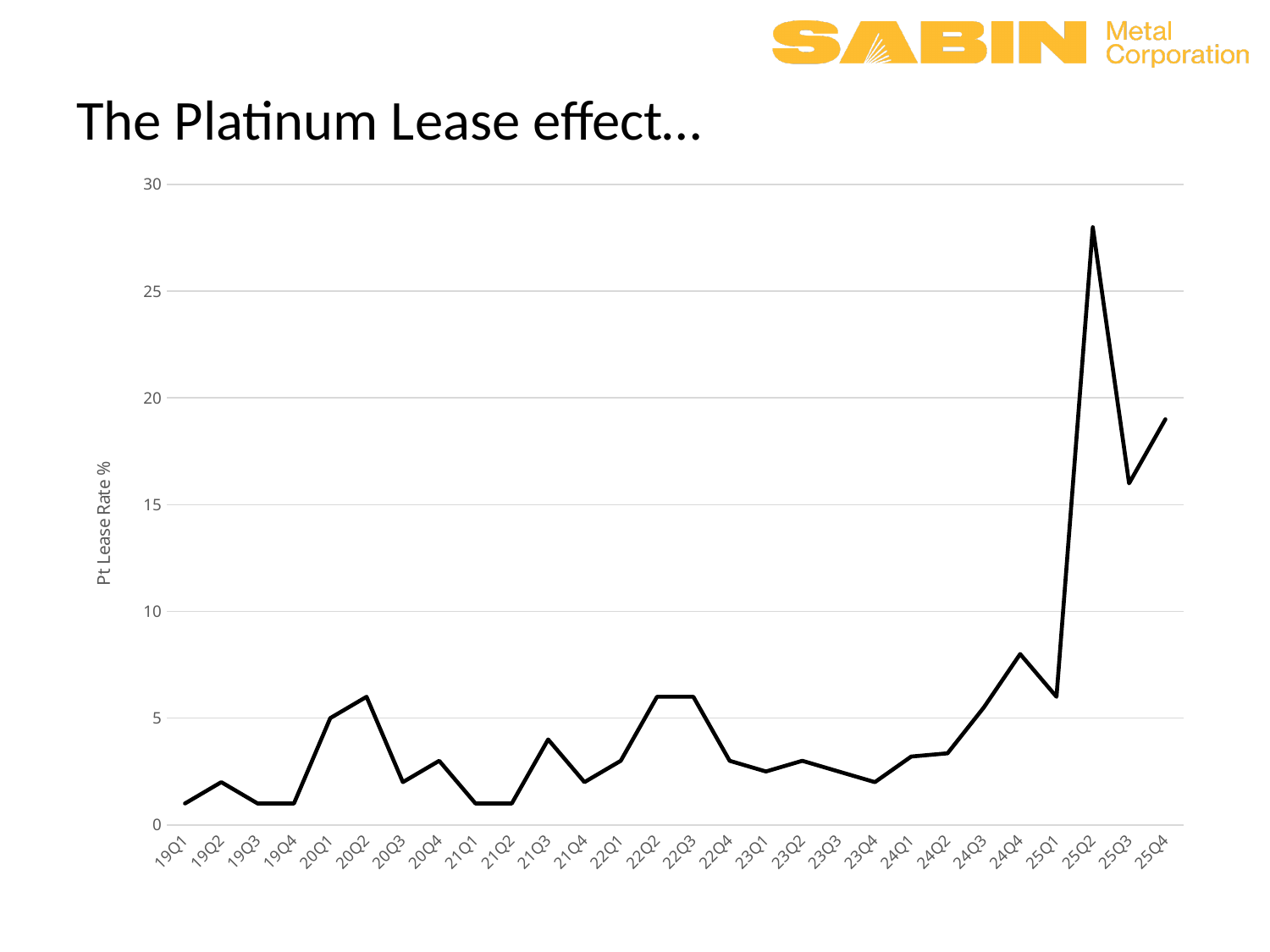
Is the value for 23Q4 greater or less than 5? less Is the value for 24Q4 greater or less than 5? greater Is the value for 25Q4 greater or less than 20? less Which is larger, the value for 24Q4 or the value for 23Q4? 24Q4 What kind of chart is shown on the slide? line chart Does the Pt lease rate rise or fall between 25Q2 and 25Q3? fall What is the label on the y axis? Pt Lease Rate % Which quarter has the highest Pt lease rate? 25Q2 Which is larger, the value for 25Q2 or the value for 25Q3? 25Q2 How many quarters are plotted along the x axis? 28